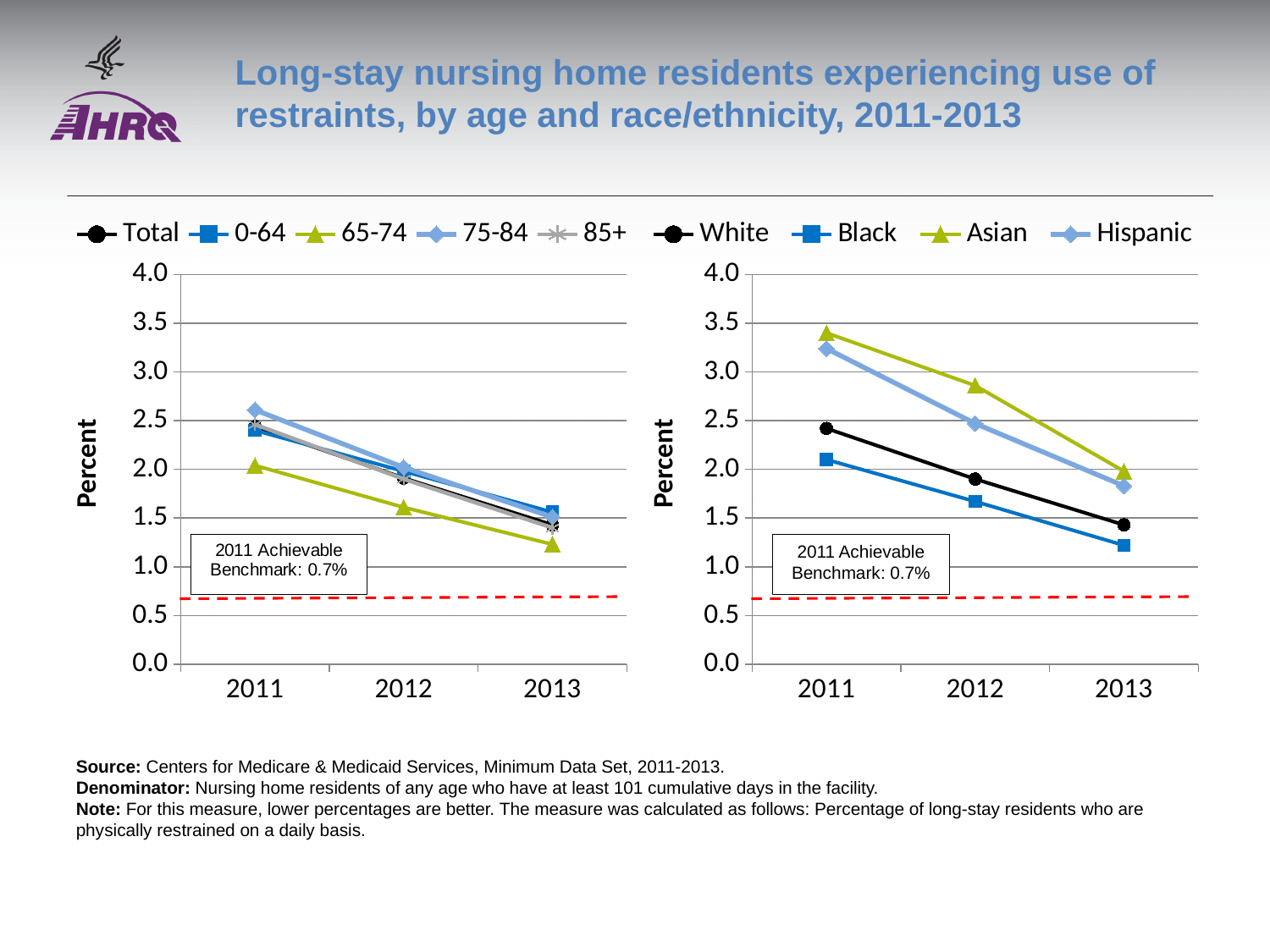
What is the 2011 Achievable Benchmark shown on the charts? 0.7% In the right chart (by race/ethnicity), does the value for Asian residents rise or fall from 2011 to 2013? fall How many series does the legend of the left chart (by age) list? 5 In the right chart (by race/ethnicity), which group has the lowest value in 2011? Black In the left chart (by age), does the value for the 65-74 group rise or fall from 2011 to 2013? fall What type of chart is the left chart (by age)? line chart In the left chart (by age), which age group has the lowest value in 2013? 65-74 In the right chart (by race/ethnicity), is the value for Asian residents in 2011 greater or less than 3.0? greater How many series does the legend of the right chart (by race/ethnicity) list? 4 In the right chart (by race/ethnicity), which group has the highest value in 2012? Asian How many years are shown on the x axis of the right chart (by race/ethnicity)? 3 In the left chart (by age), is the value for the 65-74 group in 2013 greater or less than 1.5? less